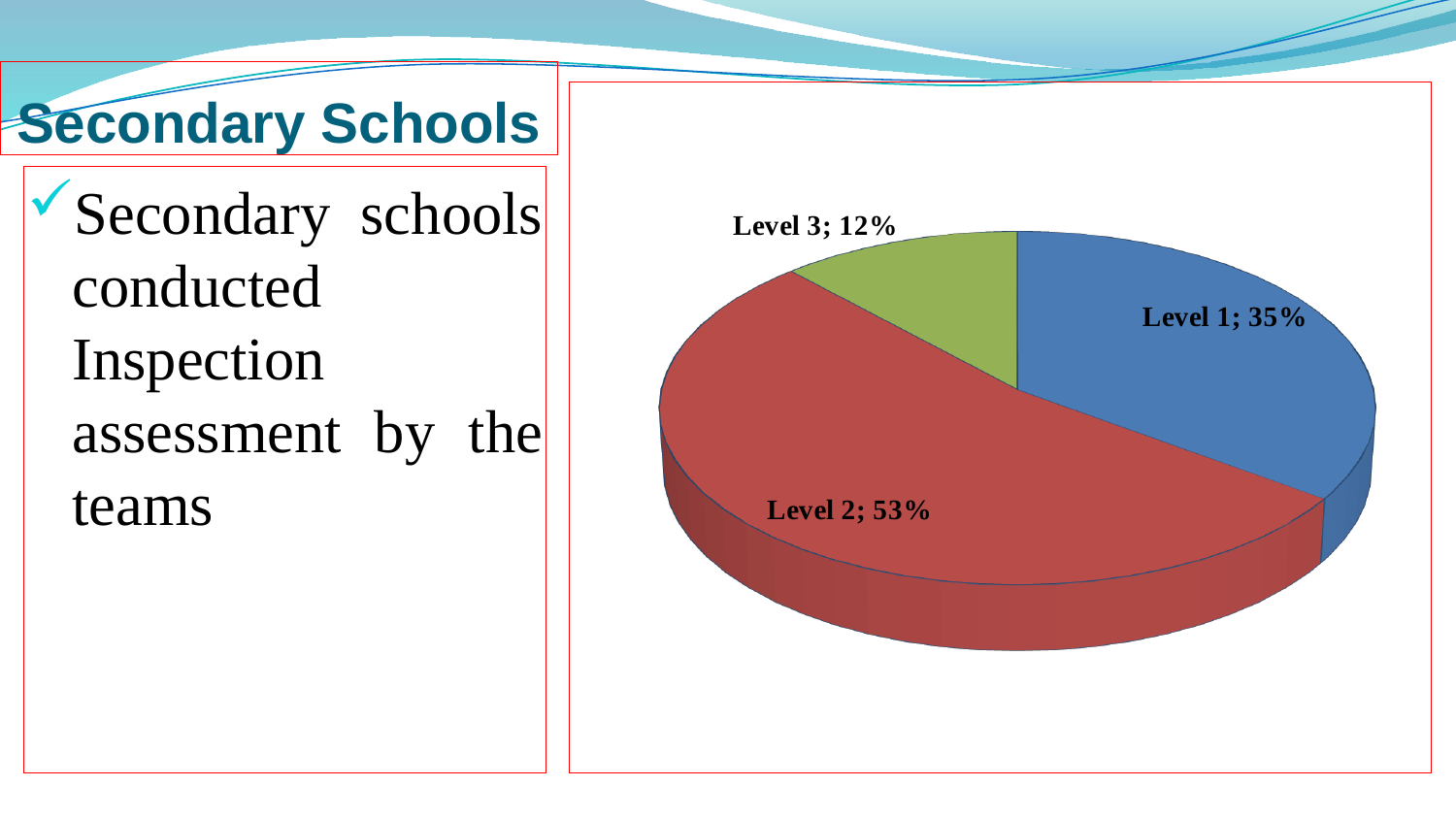
What colour is the Level 3 slice? Green What share of the pie does Level 1 represent? 35% How many slices does the pie chart have? 3 What is the difference in percentage points between Level 2 and Level 1? 18 What share of the pie does Level 2 represent? 53% What is the difference in percentage points between Level 1 and Level 3? 23 Which level has the largest slice of the pie? Level 2 Which level has the smallest slice of the pie? Level 3 What colour is the Level 2 slice? Red Which is larger, the share for Level 1 or the share for Level 3? Level 1 What share of the pie does Level 3 represent? 12% What type of chart is shown on the slide? Pie chart